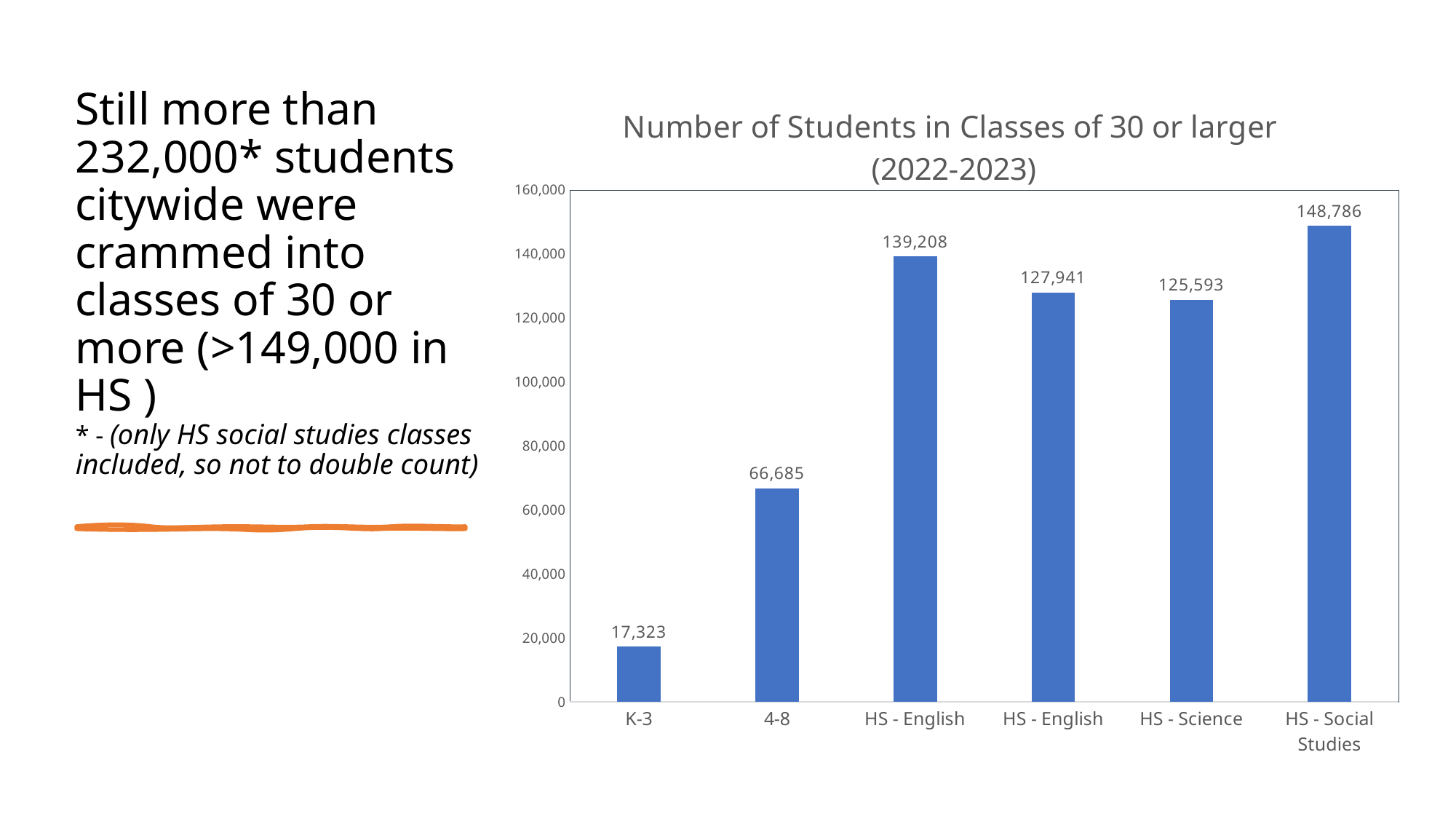
Which is larger, the value for HS - Science or the value for 4-8? HS - Science What is the value for HS - Science in the chart? 125,593 Is the value for 4-8 greater or less than 60,000? greater How many categories are shown on the x axis of the chart? 6 What is the value for HS - Social Studies in the chart? 148,786 What is the value for K-3 in the chart? 17,323 What type of chart is shown on the slide? Bar chart What is the difference between the values for HS - Social Studies and K-3? 131,463 What is the value for 4-8 in the chart? 66,685 What is the difference between the values for 4-8 and K-3? 49,362 Which category has the lowest number of students in classes of 30 or larger? K-3 Which category has the highest number of students in classes of 30 or larger? HS - Social Studies